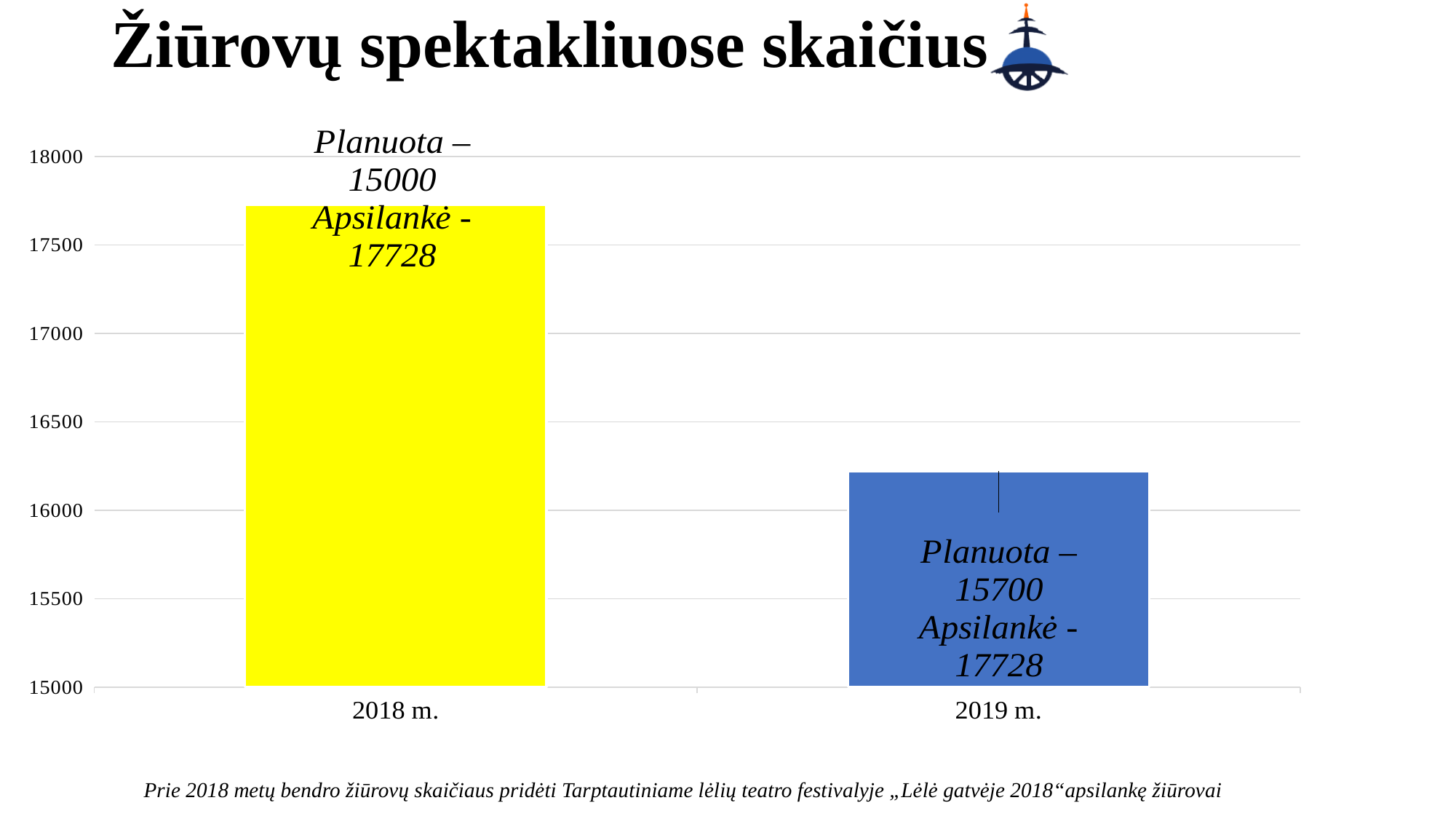
What kind of chart is shown on the slide? bar chart Which year has the shorter bar in the chart? 2019 m. Do the bar values rise or fall from 2018 m. to 2019 m.? fall Is the value for 2018 m. greater or less than 18000? less Is the bar for 2018 m. taller or shorter than the bar for 2019 m.? taller Is the value for 2018 m. greater or less than 17500? greater Is the value for 2019 m. greater or less than 16500? less What colour is the bar for 2019 m.? blue How many bars (categories) does the chart show? 2 What is the title of the slide containing the chart? Žiūrovų spektakliuose skaičius Which year has the taller bar in the chart? 2018 m.